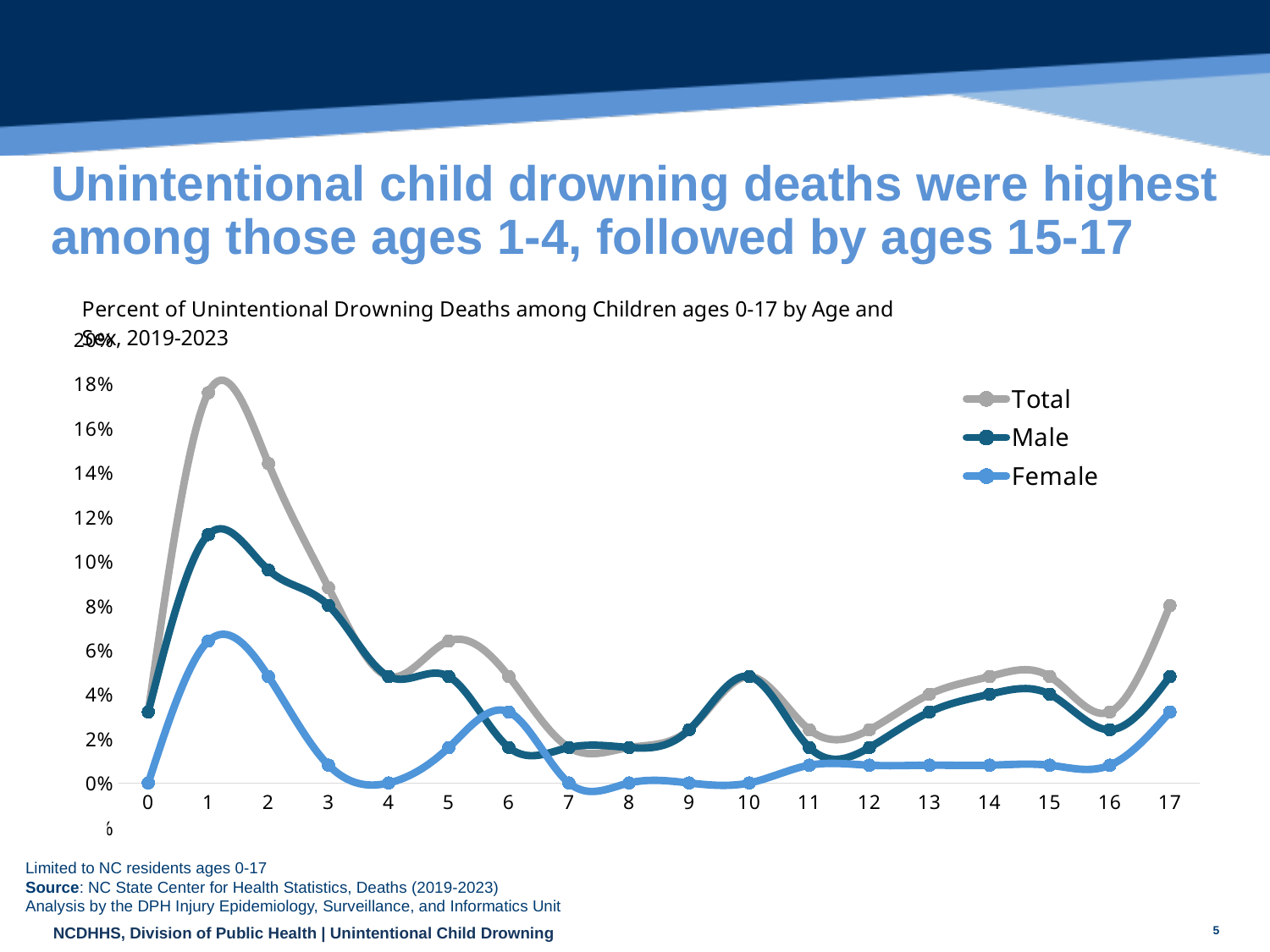
Is the Total value at age 1 greater or less than 16%? greater Is the Male value at age 1 greater or less than 10%? greater What kind of chart is shown on the slide? Line chart How many series does the legend list? 3 At which age is the Male series highest? 1 Does the Total series rise or fall from age 1 to age 4? Fall Is the Total value at age 7 greater or less than 4%? less Which series are listed in the legend? Total, Male, Female How many ages are plotted along the x axis? 18 At which age is the Total series highest? 1 At age 1, which is larger, the Male value or the Female value? Male